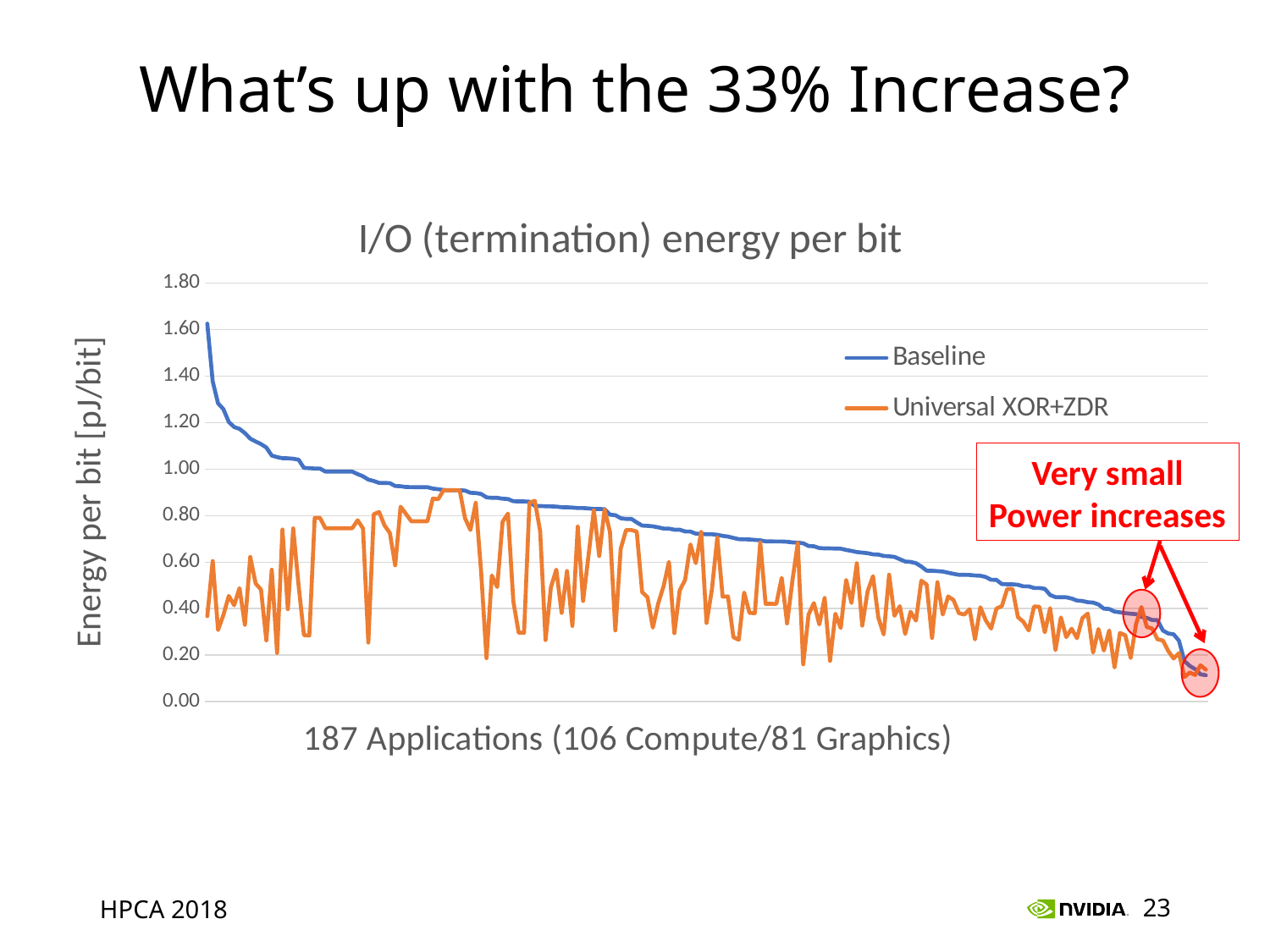
Is the Baseline value for the first (leftmost) application greater or less than 1.80? less Is the Baseline value for the last (rightmost) application greater or less than 0.40? less Is the highest Universal XOR+ZDR value greater or less than 1.00? less Which series reaches the higher peak value, Baseline or Universal XOR+ZDR? Baseline What kind of chart is shown on the slide? Line chart How many series does the legend list? 2 What is the title of the chart? I/O (termination) energy per bit What is the label on the y axis? Energy per bit [pJ/bit] What are the two series named in the legend? Baseline and Universal XOR+ZDR Does the Baseline series rise or fall along the x axis? Fall How many applications are plotted along the x axis, according to the axis label? 187